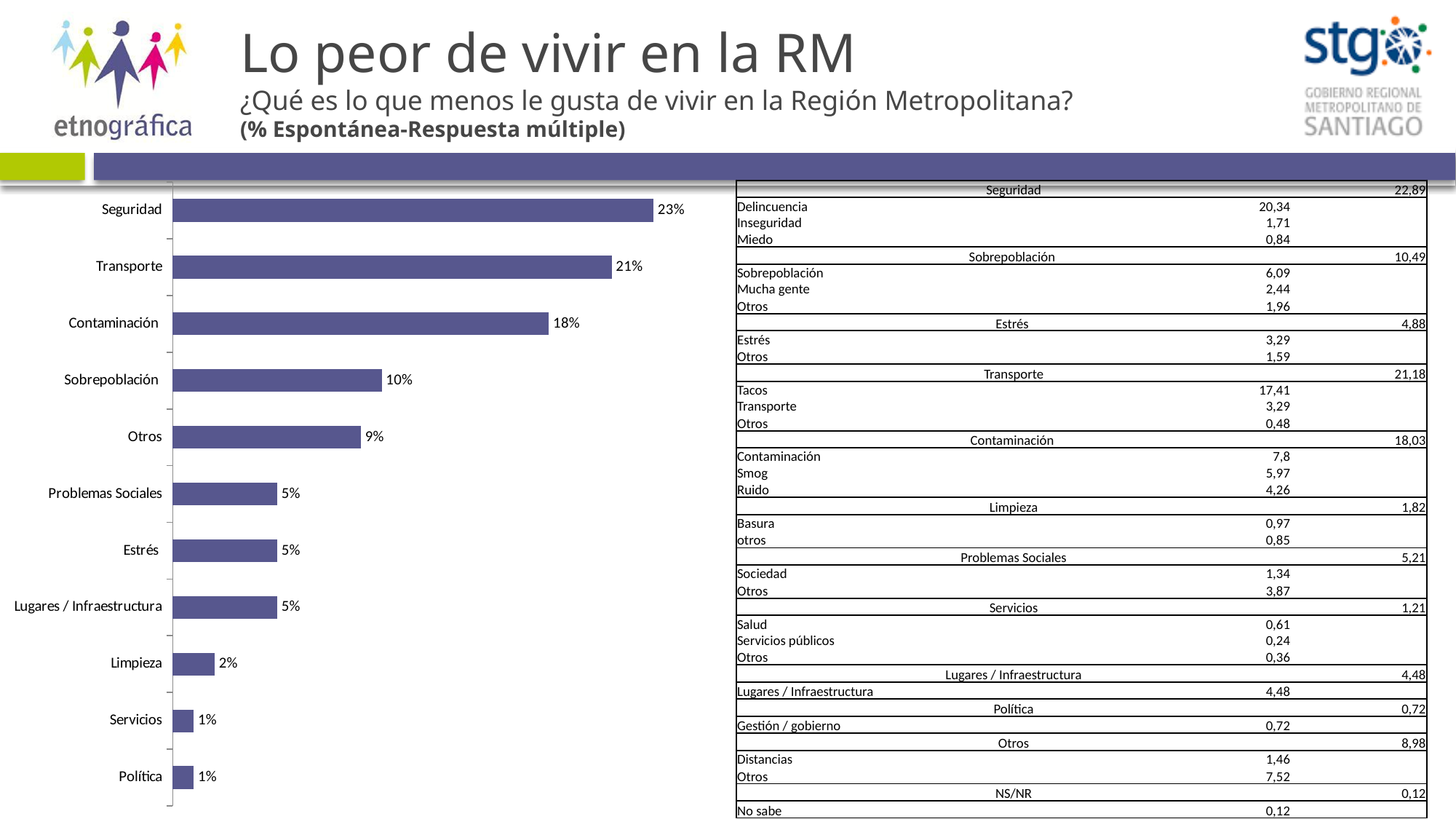
How many categories are shown in the bar chart? 11 Which category has the highest value in the bar chart? Seguridad What is the main title of the slide? Lo peor de vivir en la RM What is the value for Contaminación in the bar chart? 18% What is the value for Transporte in the bar chart? 21% What is the value for Limpieza in the bar chart? 2% What is the value for Seguridad in the bar chart? 23% What is the difference between the values for Seguridad and Transporte in the bar chart? 2% What is the value for Sobrepoblación in the bar chart? 10% What kind of chart is shown on the slide? Bar chart Which is larger in the bar chart, the value for Otros or the value for Problemas Sociales? Otros What is the difference between the values for Contaminación and Sobrepoblación in the bar chart? 8%